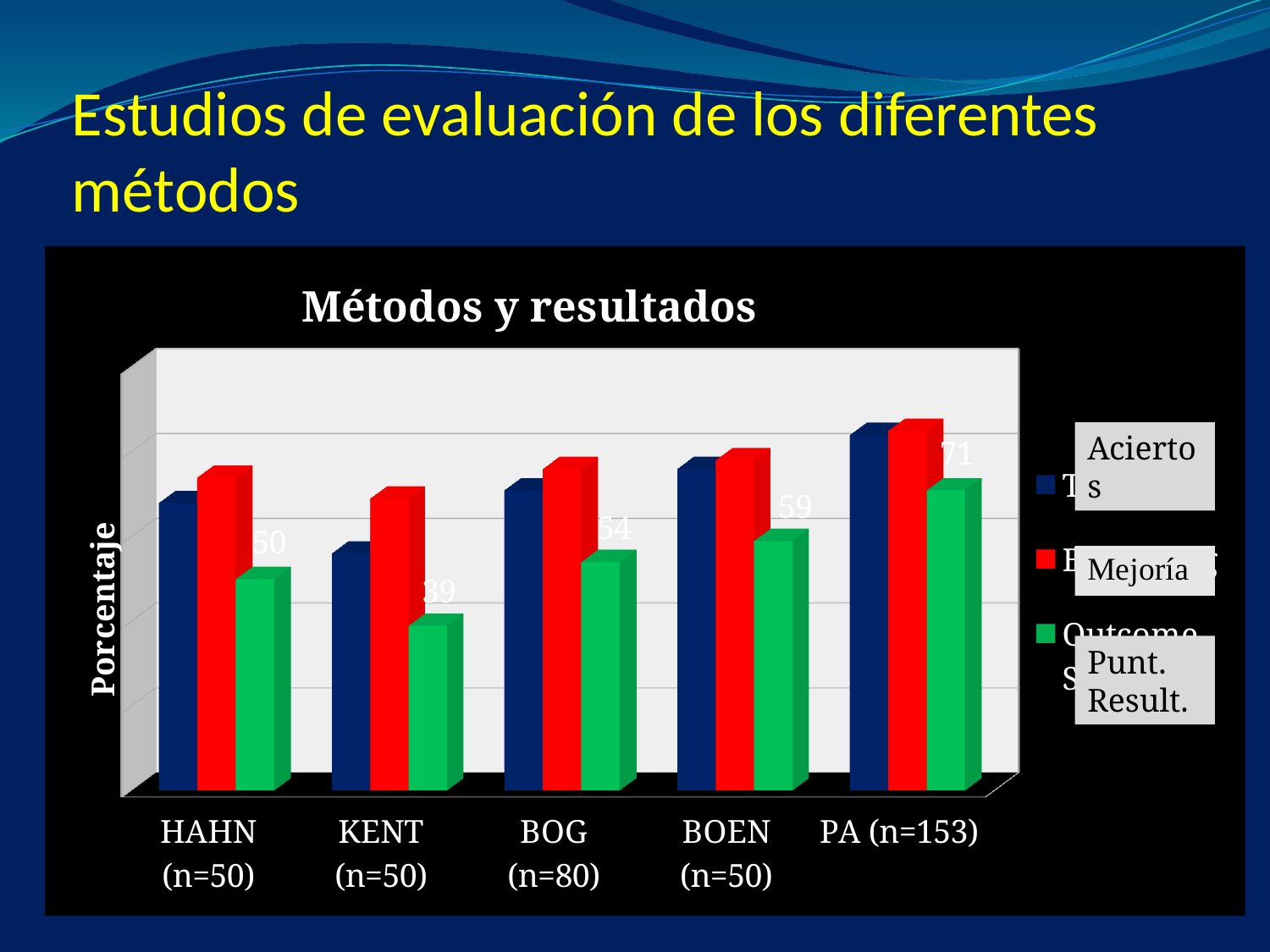
How many categories (methods) are shown on the x axis of the chart? 5 For KENT (n=50), which bar is taller: the red (Mejoría) bar or the green (Punt. Result.) bar? Red (Mejoría) What is the labelled value of the green (Punt. Result.) bar for PA (n=153)? 71 How many series does the chart's legend list? 3 What is the title of the chart? Métodos y resultados Which category has the lowest labelled green (Punt. Result.) value? KENT (n=50) What is the labelled value of the green (Punt. Result.) bar for KENT (n=50)? 39 What is the label on the vertical axis of the chart? Porcentaje What type of chart is shown on the slide? Bar chart What is the difference between the labelled green values for PA (n=153) and KENT (n=50)? 32 Which category has the highest labelled green (Punt. Result.) value? PA (n=153) What is the labelled value of the green (Punt. Result.) bar for HAHN (n=50)? 50